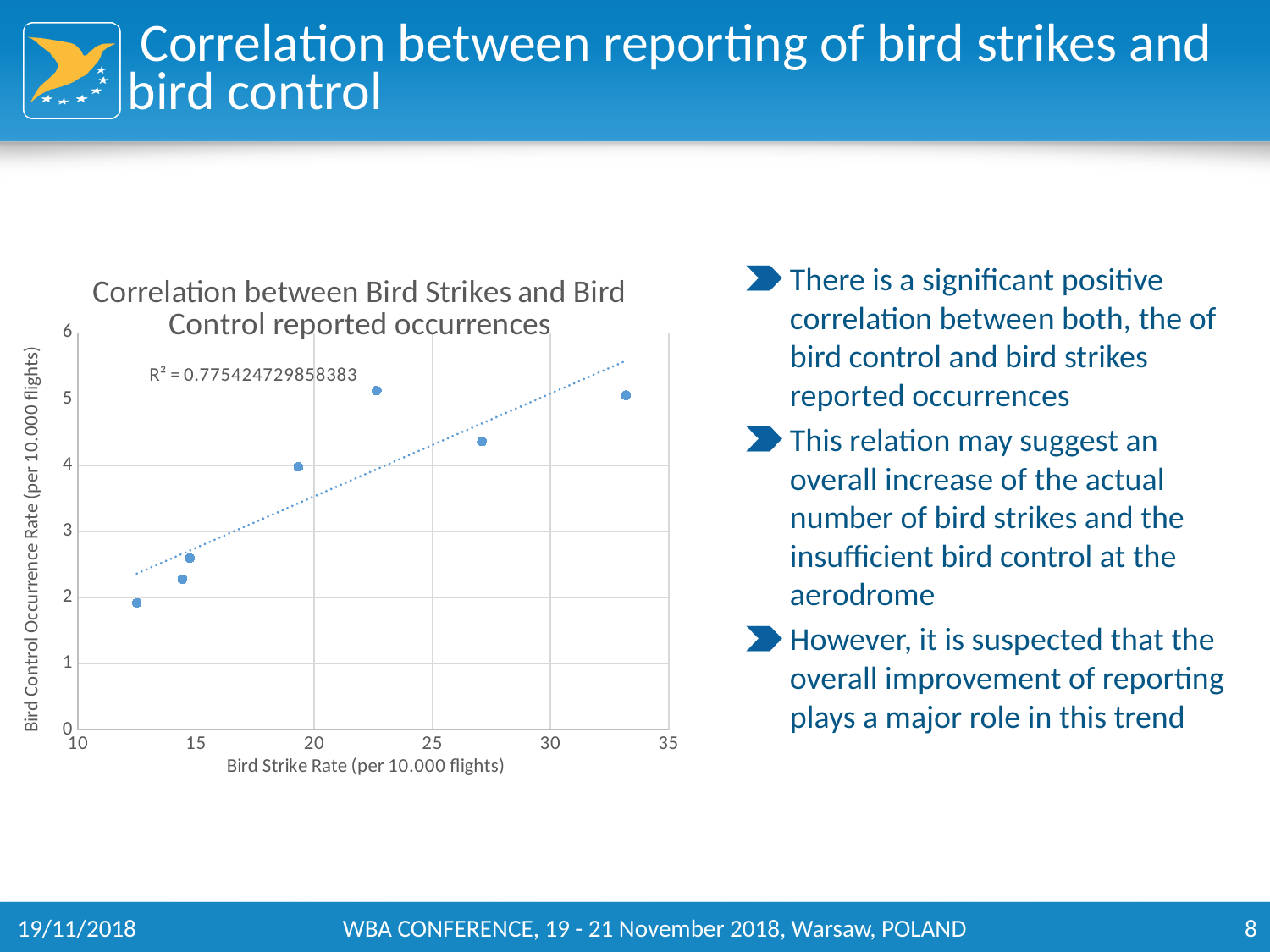
How many data points are plotted in the scatter chart? 7 What is the label of the x axis? Bird Strike Rate (per 10.000 flights) What is the R² value printed on the chart? R² = 0.775424729858383 What kind of chart is shown on the slide? scatter chart Is the bird control occurrence rate for the point with the lowest bird strike rate greater or less than 3? less Which has the higher bird control occurrence rate: the point with the lowest bird strike rate or the point with the highest bird strike rate? the point with the highest bird strike rate Is the bird strike rate of the point with the lowest bird control occurrence rate greater or less than 15? less Is the bird control occurrence rate for the point with the highest bird strike rate greater or less than 4? greater What is the highest value shown on the y axis? 6 Do the plotted values generally rise or fall as the bird strike rate increases along the x axis? rise What is the title of the chart? Correlation between Bird Strikes and Bird Control reported occurrences